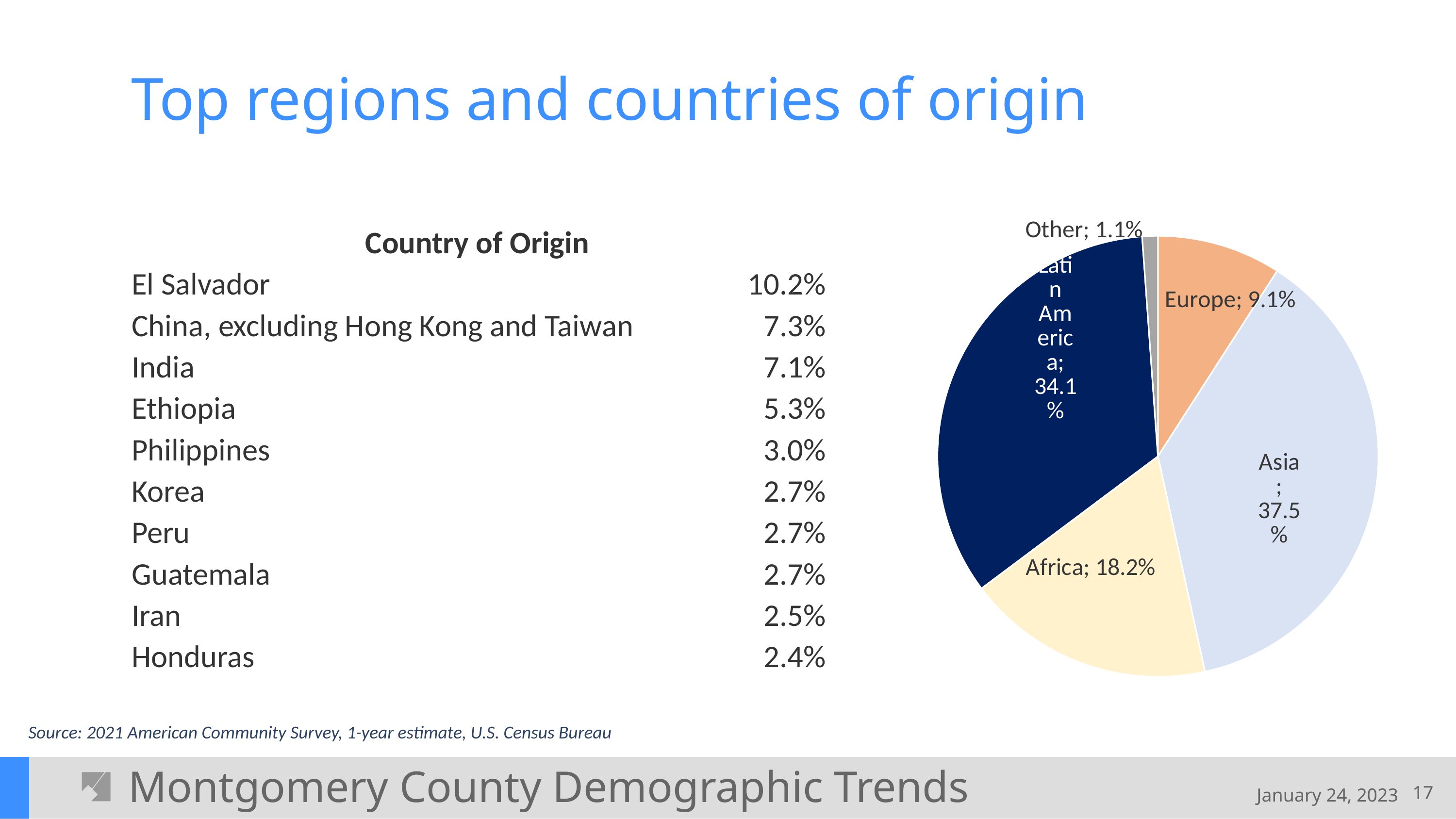
In the pie chart, what is the difference between the shares of Africa and Europe? 9.1% In the pie chart, what share does Latin America have? 34.1% In the pie chart, which is larger, the share for Africa or the share for Europe? Africa In the pie chart, what share does Africa have? 18.2% Which region has the largest slice in the pie chart? Asia In the pie chart, what share does Europe have? 9.1% In the pie chart, what share does Asia have? 37.5% In the pie chart, what is the difference between the shares of Asia and Latin America? 3.4% Which region has the smallest slice in the pie chart? Other How many slices does the pie chart have? 5 What kind of chart is shown on the slide? pie chart In the pie chart, what share does Other have? 1.1%